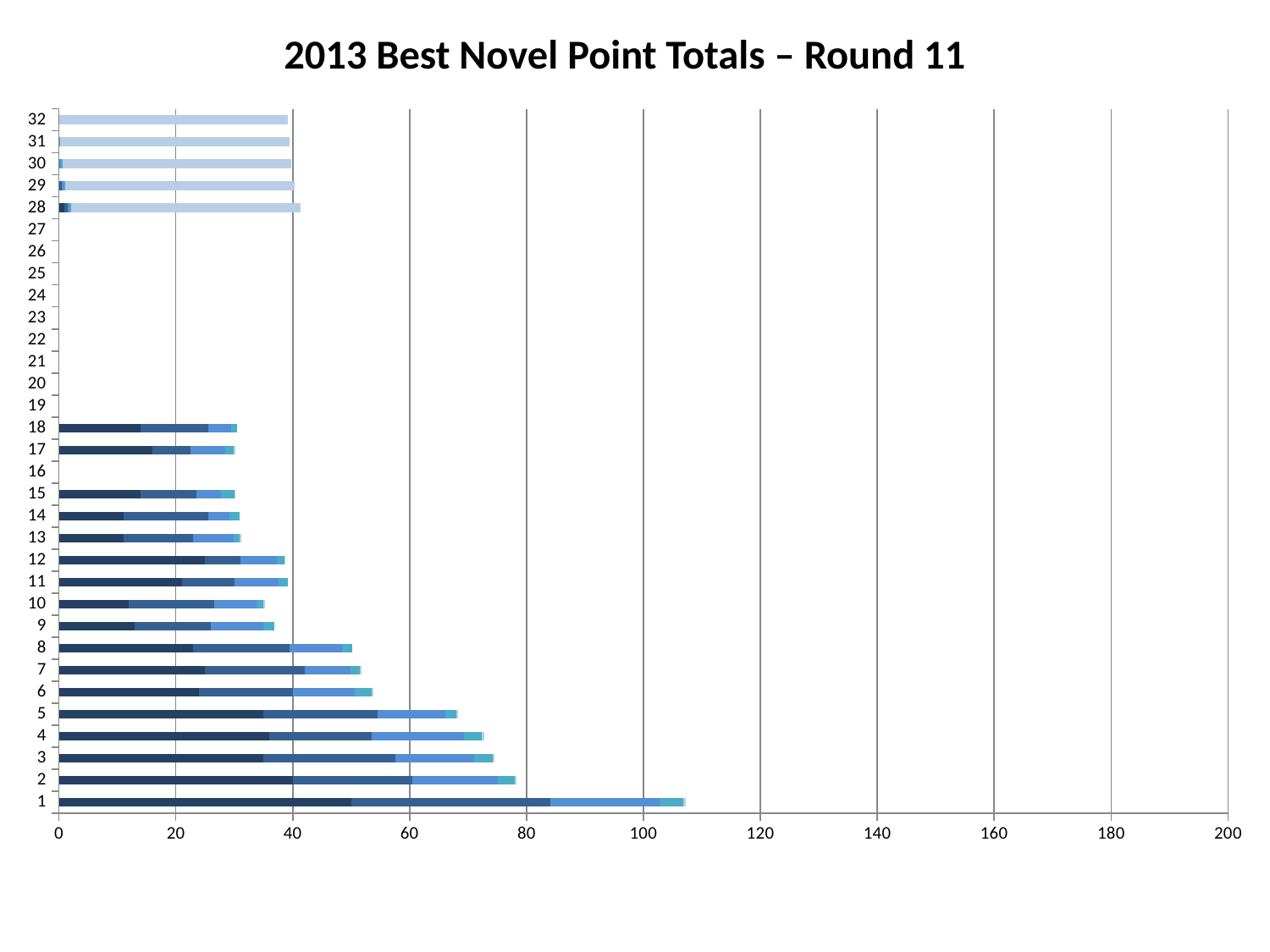
Is the total value for category 5 greater or less than 60? greater Is the total value for category 1 greater or less than 100? greater Which has the larger total, category 1 or category 2? 1 How many categories are listed on the vertical axis? 32 Which category has the longest bar? 1 What kind of chart is shown on the slide? bar chart Is the total value for category 3 greater or less than 80? less What is the title of the chart? 2013 Best Novel Point Totals – Round 11 Which has the larger total, category 5 or category 8? 5 What is the highest value shown on the horizontal axis? 200